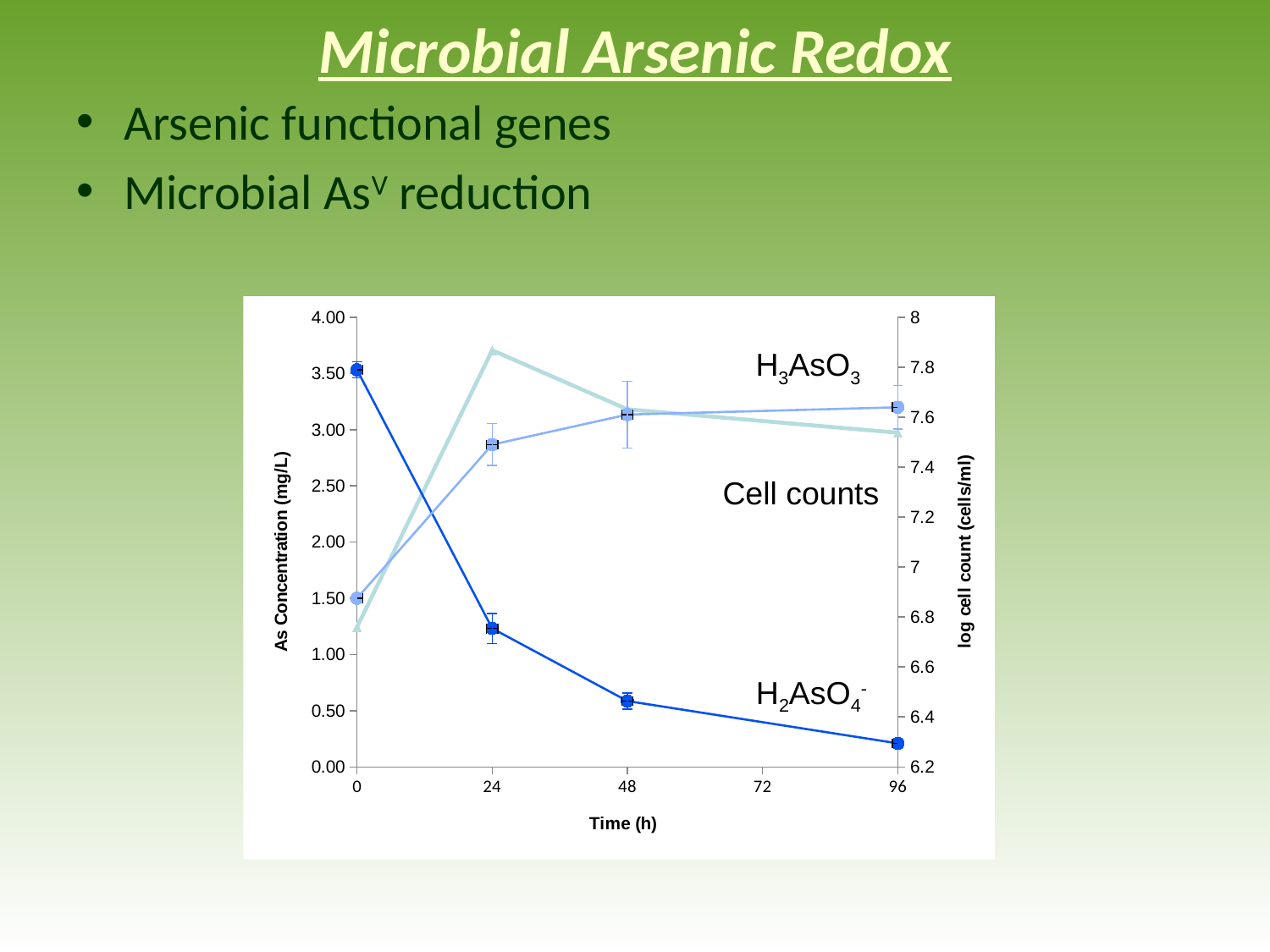
Does the H2AsO4- concentration rise or fall as time increases? fall At 96 h, which is larger: the H3AsO3 concentration or the H2AsO4- concentration? H3AsO3 Is the H2AsO4- concentration at 0 h greater or less than 3.00 mg/L? greater What is the title of the x axis of the chart? Time (h) Is the H2AsO4- concentration at 96 h greater or less than 0.50 mg/L? less How many tick labels are shown on the Time (h) axis? 5 How many series are plotted on the chart? 3 What kind of chart is shown on the slide? line chart At which time is the H3AsO3 concentration highest? 96 At which time is the H2AsO4- concentration lowest? 96 At which time is the H2AsO4- concentration highest? 0 Do the cell counts rise or fall from 0 h to 96 h? rise